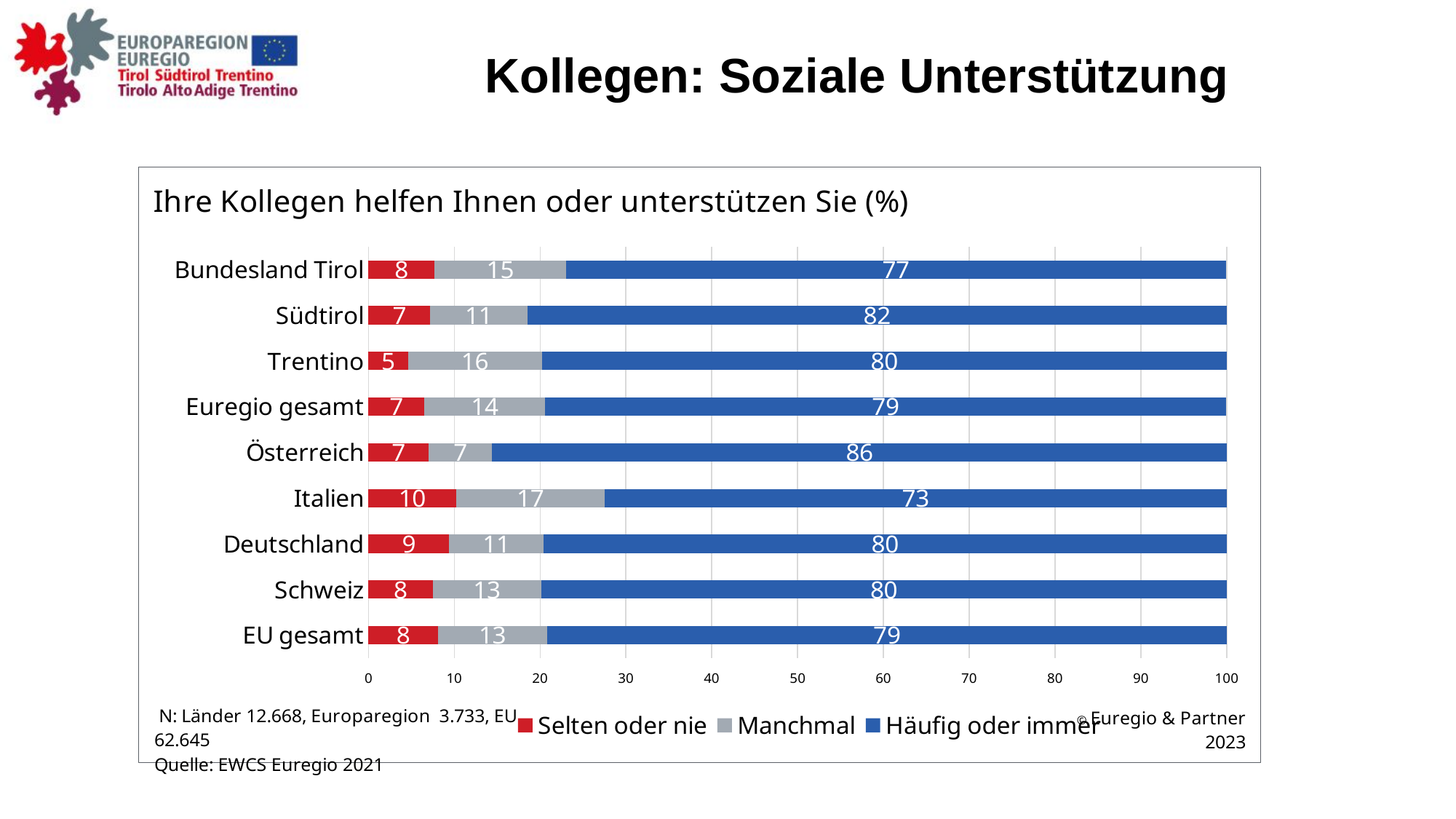
How many categories are shown on the y axis? 9 Which category has the lowest value for "Selten oder nie"? Trentino What is the value for "Häufig oder immer" for Österreich? 86 What is the difference between the "Häufig oder immer" values for Südtirol and Bundesland Tirol? 5 Which category has the lowest value for "Häufig oder immer"? Italien What is the value for "Manchmal" for Trentino? 16 How many series does the legend list? 3 Which is larger: the "Manchmal" value for Italien or for Österreich? Italien What kind of chart is shown? Stacked bar chart What is the value for "Selten oder nie" for Italien? 10 What is the total of the stacked bar for Euregio gesamt? 100 Which category has the highest value for "Häufig oder immer"? Österreich